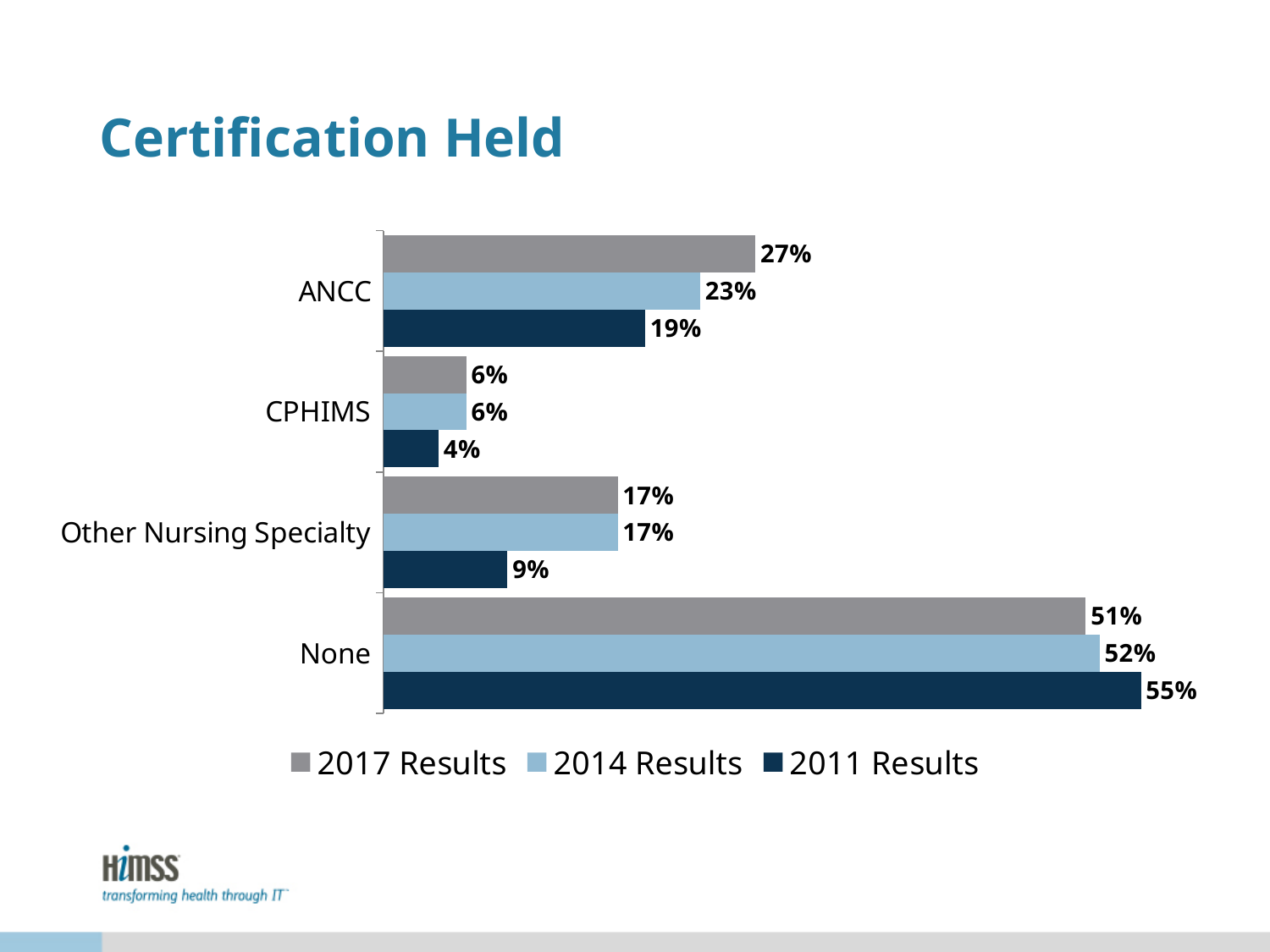
What is the 2017 Results value for ANCC? 27% Which is larger for None: the 2014 Results value or the 2017 Results value? 2014 Results Which category has the lowest 2011 Results value? CPHIMS What is the 2014 Results value for Other Nursing Specialty? 17% How many categories are shown on the chart? 4 What is the 2011 Results value for None? 55% What kind of chart is shown on the slide? Bar chart How many series does the legend list? 3 What is the 2011 Results value for CPHIMS? 4% What is the title of the chart? Certification Held Which category has the highest 2017 Results value? None What is the difference between the 2017 Results and 2011 Results values for ANCC? 8%